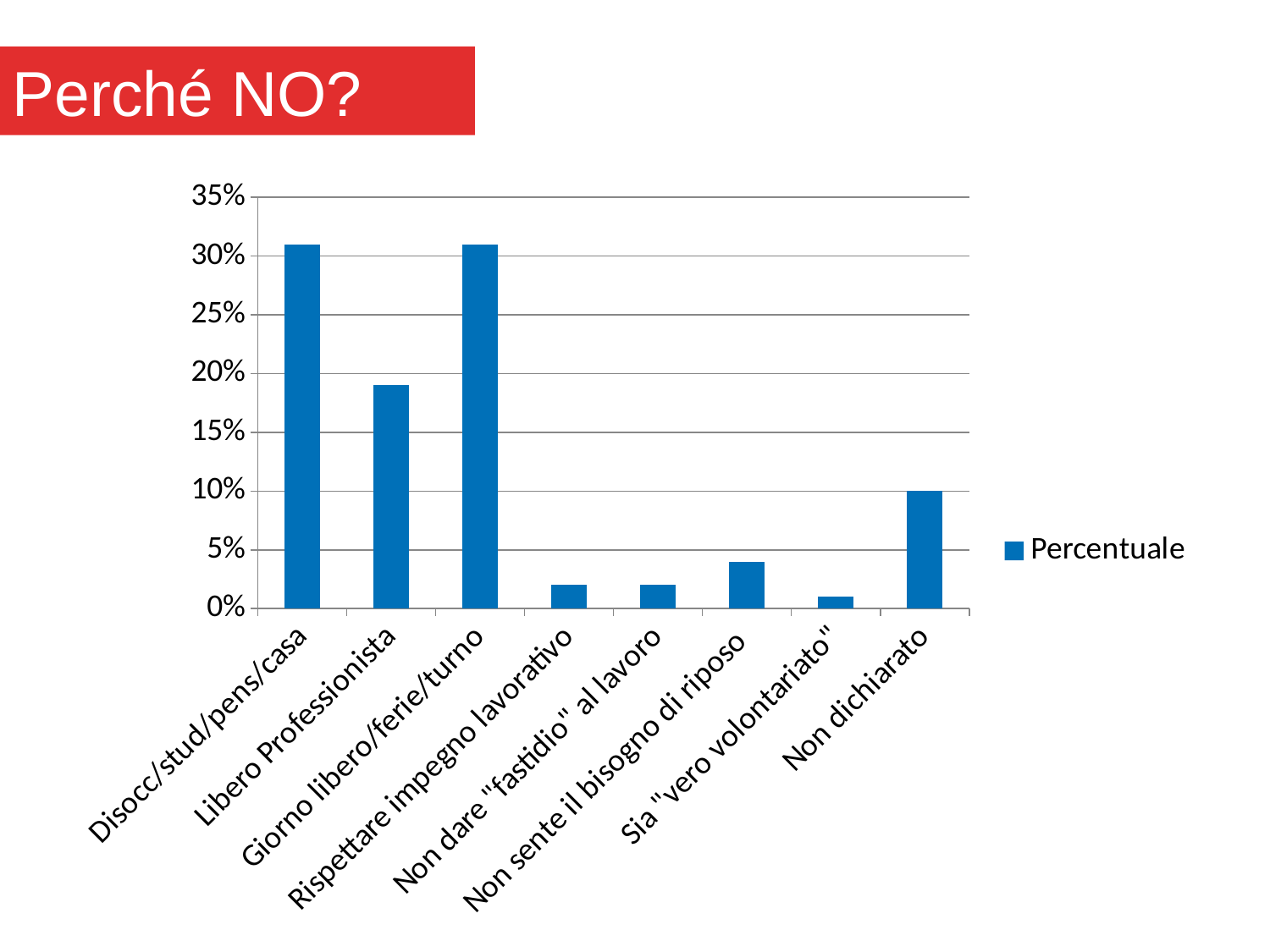
What is the value for Non dichiarato? 10% How many series does the chart's legend list? 1 Is the value for Libero Professionista greater or less than 20%? less Which is larger, the value for Non sente il bisogno di riposo or the value for Rispettare impegno lavorativo? Non sente il bisogno di riposo Is the value for Disocc/stud/pens/casa greater or less than 30%? greater What is the title shown above the chart on the slide? Perché NO? Which is larger, the value for Libero Professionista or the value for Non dichiarato? Libero Professionista Is the value for Giorno libero/ferie/turno greater or less than 25%? greater What kind of chart is shown on the slide? bar chart What is the name of the series shown in the chart's legend? Percentuale How many categories are shown on the x axis of the chart? 8